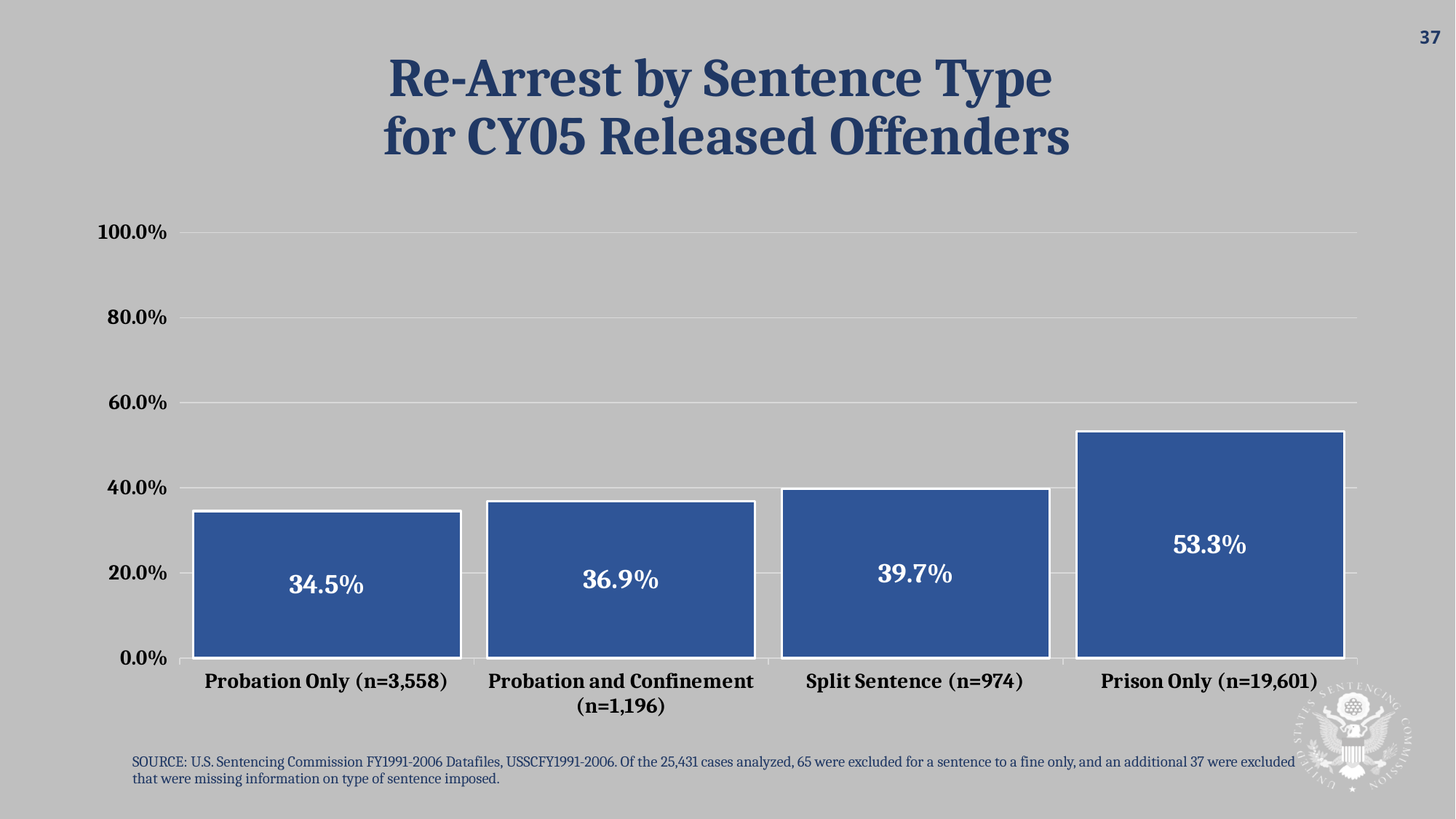
What is the re-arrest rate for Probation Only offenders? 34.5% How many sentence types are shown in the chart? 4 Which sentence type has the highest re-arrest rate? Prison Only What is the re-arrest rate for Split Sentence offenders? 39.7% What is the re-arrest rate for Prison Only offenders? 53.3% Which sentence type has the lowest re-arrest rate? Probation Only Is the re-arrest rate for Prison Only greater or less than 40.0%? greater What is the re-arrest rate for Probation and Confinement offenders? 36.9% What kind of chart is shown on the slide? Bar chart Do the re-arrest rates rise or fall from left to right across the sentence types? Rise What is the difference in re-arrest rate between Prison Only and Probation Only? 18.8% Which has a higher re-arrest rate, Split Sentence or Probation and Confinement? Split Sentence